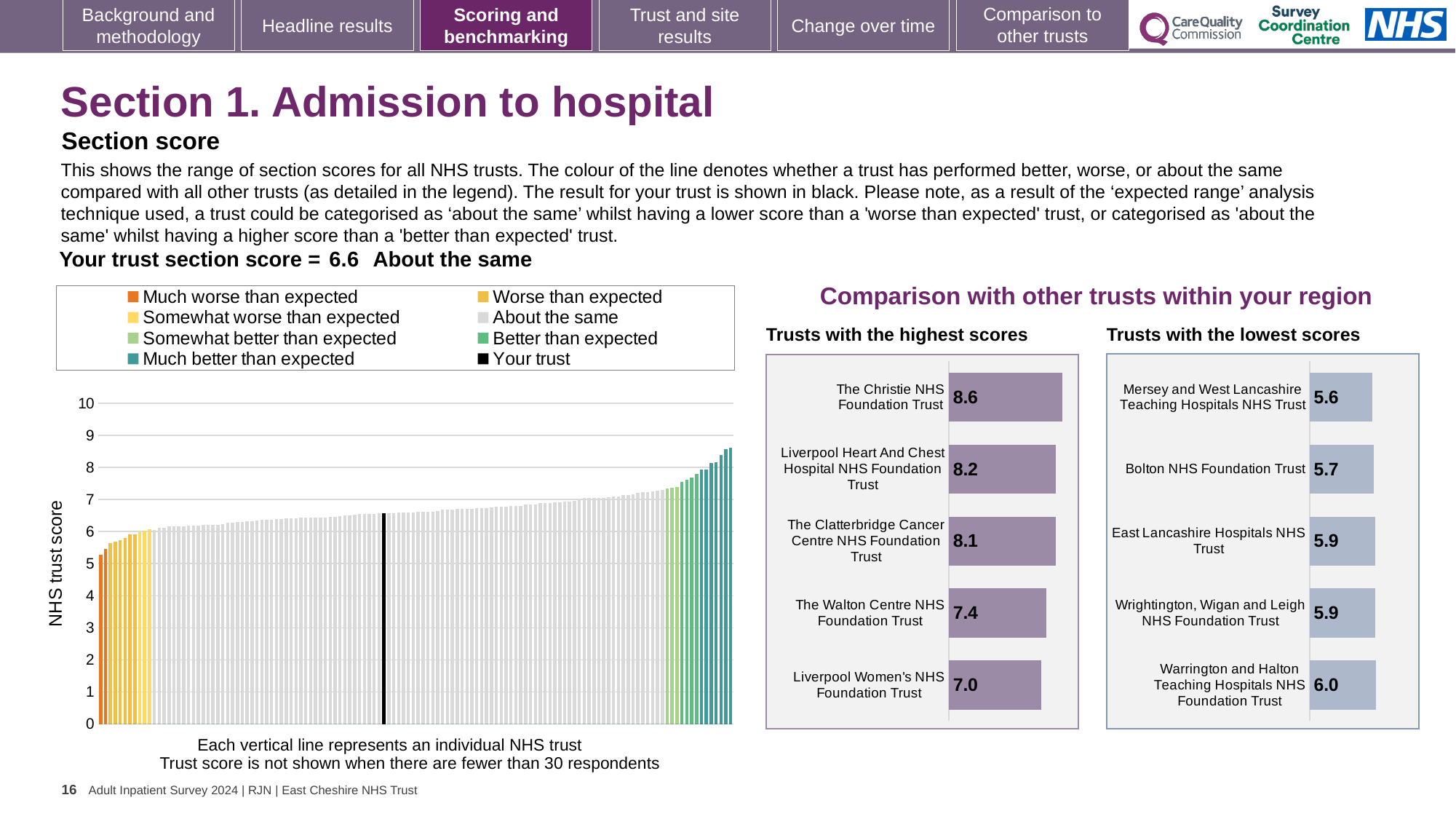
In the 'Trusts with the highest scores' chart, which trust has the lowest score shown? Liverpool Women's NHS Foundation Trust How many entries does the legend above the main 'NHS trust score' chart list? 8 In the 'Trusts with the lowest scores' chart, which trust has the lowest score? Mersey and West Lancashire Teaching Hospitals NHS Trust In the 'Trusts with the lowest scores' chart, what is the score for Bolton NHS Foundation Trust? 5.7 In the 'Trusts with the highest scores' chart, what is the score for The Christie NHS Foundation Trust? 8.6 In the 'Trusts with the highest scores' chart, what is the difference between the scores of The Christie NHS Foundation Trust and Liverpool Women's NHS Foundation Trust? 1.6 In the 'Trusts with the lowest scores' chart, what is the difference between the scores of Warrington and Halton Teaching Hospitals NHS Foundation Trust and Mersey and West Lancashire Teaching Hospitals NHS Trust? 0.4 How many trusts are listed in the 'Trusts with the lowest scores' chart? 5 In the main 'NHS trust score' chart on the left, what is the section score for your trust (the black bar)? 6.6 In the main 'NHS trust score' chart on the left, do the trust scores rise or fall from left to right? rise In the 'Trusts with the highest scores' chart, what is the score for The Walton Centre NHS Foundation Trust? 7.4 In the 'Trusts with the highest scores' chart, which has a higher score: Liverpool Heart And Chest Hospital NHS Foundation Trust or The Clatterbridge Cancer Centre NHS Foundation Trust? Liverpool Heart And Chest Hospital NHS Foundation Trust